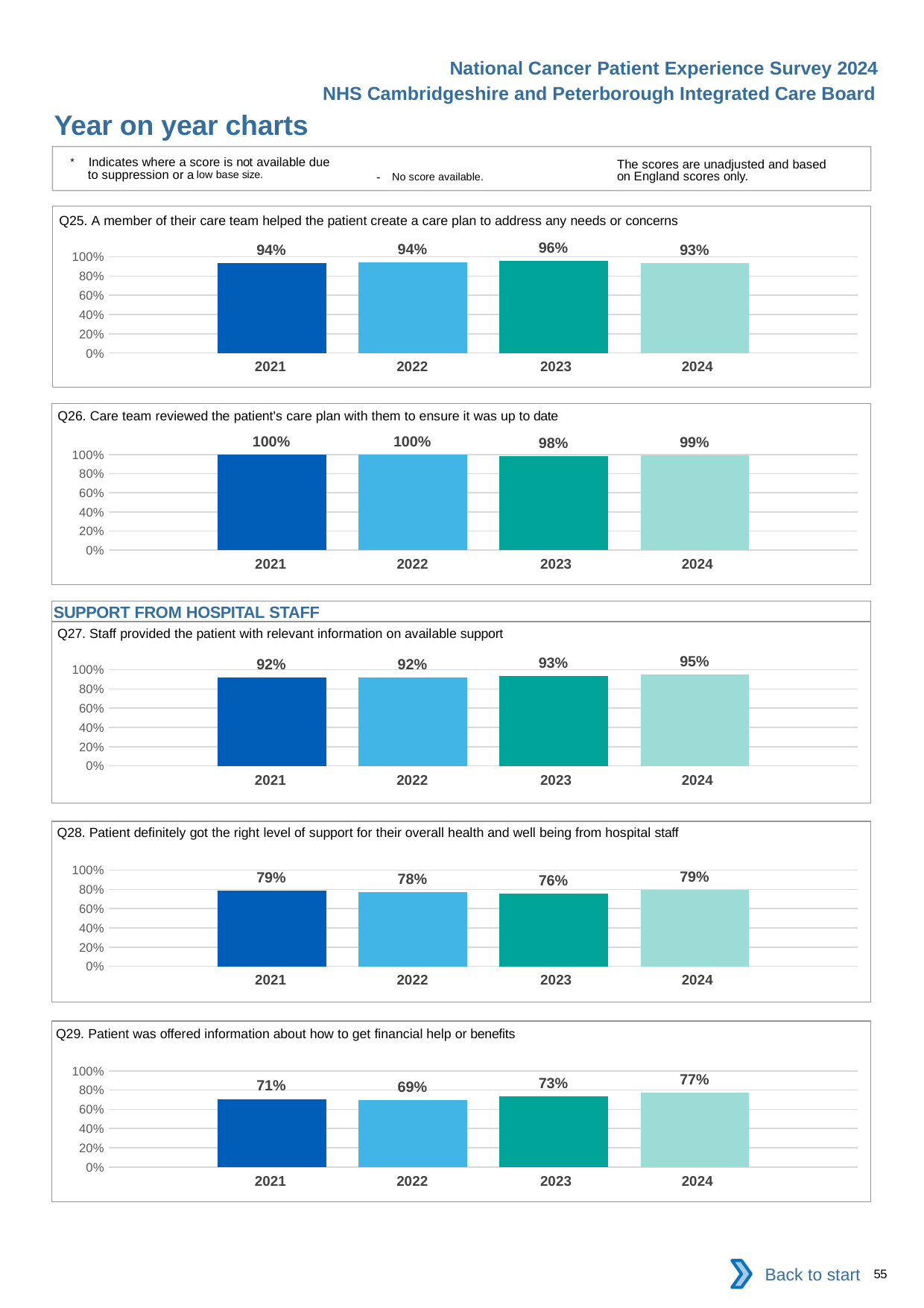
What kind of chart is the Q26 chart? bar chart In the Q25 chart, what is the value for 2023? 96% In the Q29 chart, what is the value for 2021? 71% In the Q26 chart, what is the value for 2024? 99% In the Q26 chart, which year has the lowest value? 2023 In the Q27 chart, do the values rise or fall from 2022 to 2024? rise In the Q29 chart, which year has the highest value? 2024 What is the section heading printed above the Q27 chart? SUPPORT FROM HOSPITAL STAFF In the Q29 chart, is the value for 2022 larger or smaller than the value for 2023? smaller In the Q28 chart, which year has the lowest value? 2023 How many years are shown in the Q28 chart? 4 In the Q27 chart, what is the difference between the 2024 and 2021 values? 3 percentage points